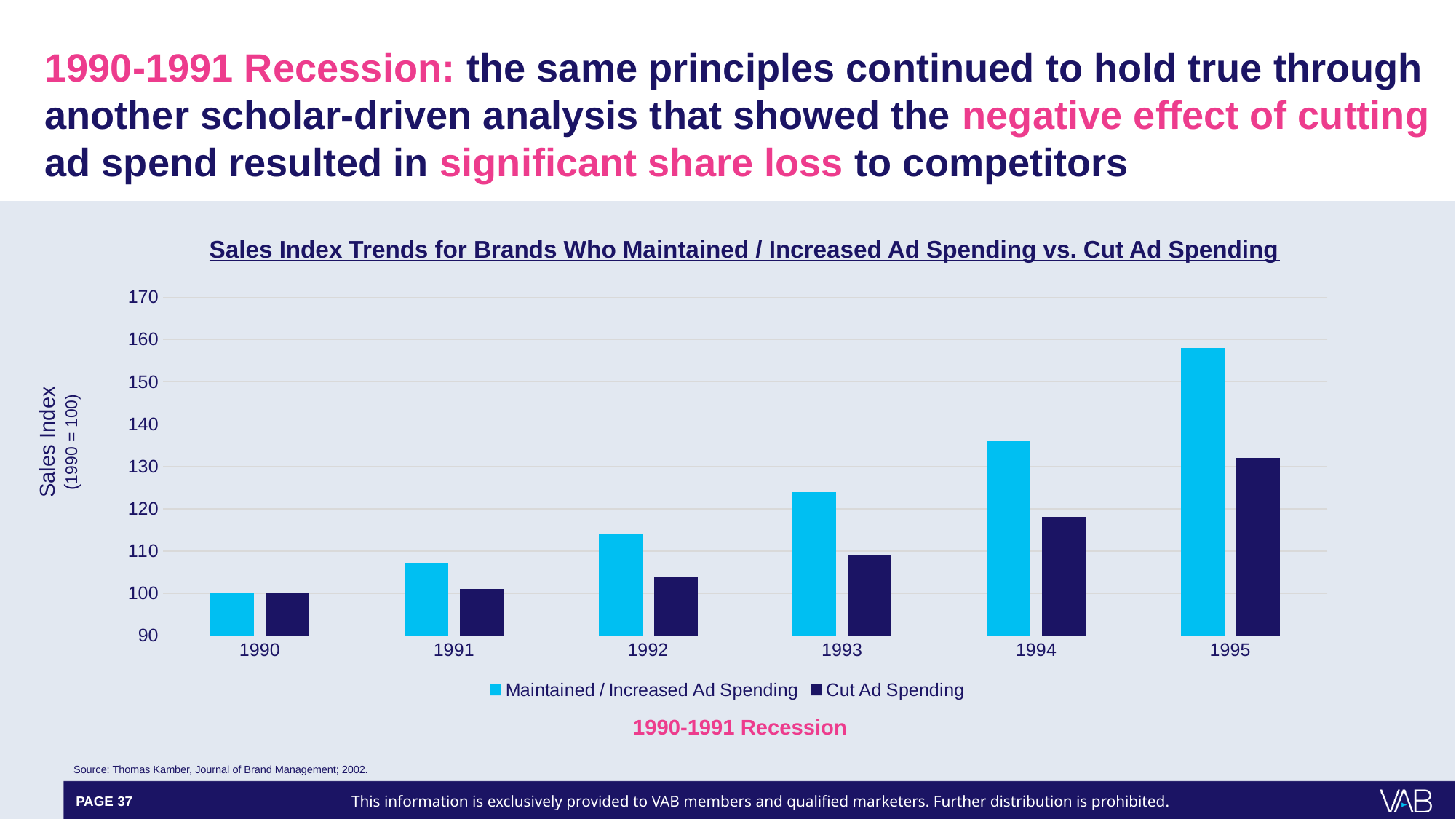
In which year is the Cut Ad Spending bar lowest? 1990 In which year is the Maintained / Increased Ad Spending bar highest? 1995 Is the value for Cut Ad Spending in 1993 greater or less than 120? less In 1995, which series has the larger value: Maintained / Increased Ad Spending or Cut Ad Spending? Maintained / Increased Ad Spending Is the value for Maintained / Increased Ad Spending in 1995 greater or less than 150? greater Is the value for Maintained / Increased Ad Spending in 1994 greater or less than 130? greater Do the Maintained / Increased Ad Spending values rise or fall from 1990 to 1995? Rise What is the Sales Index value for Cut Ad Spending in 1990? 100 How many series does the legend list? 2 How many years are shown on the x axis? 6 What type of chart is shown on the slide? Bar chart What is the Sales Index value for Maintained / Increased Ad Spending in 1990? 100